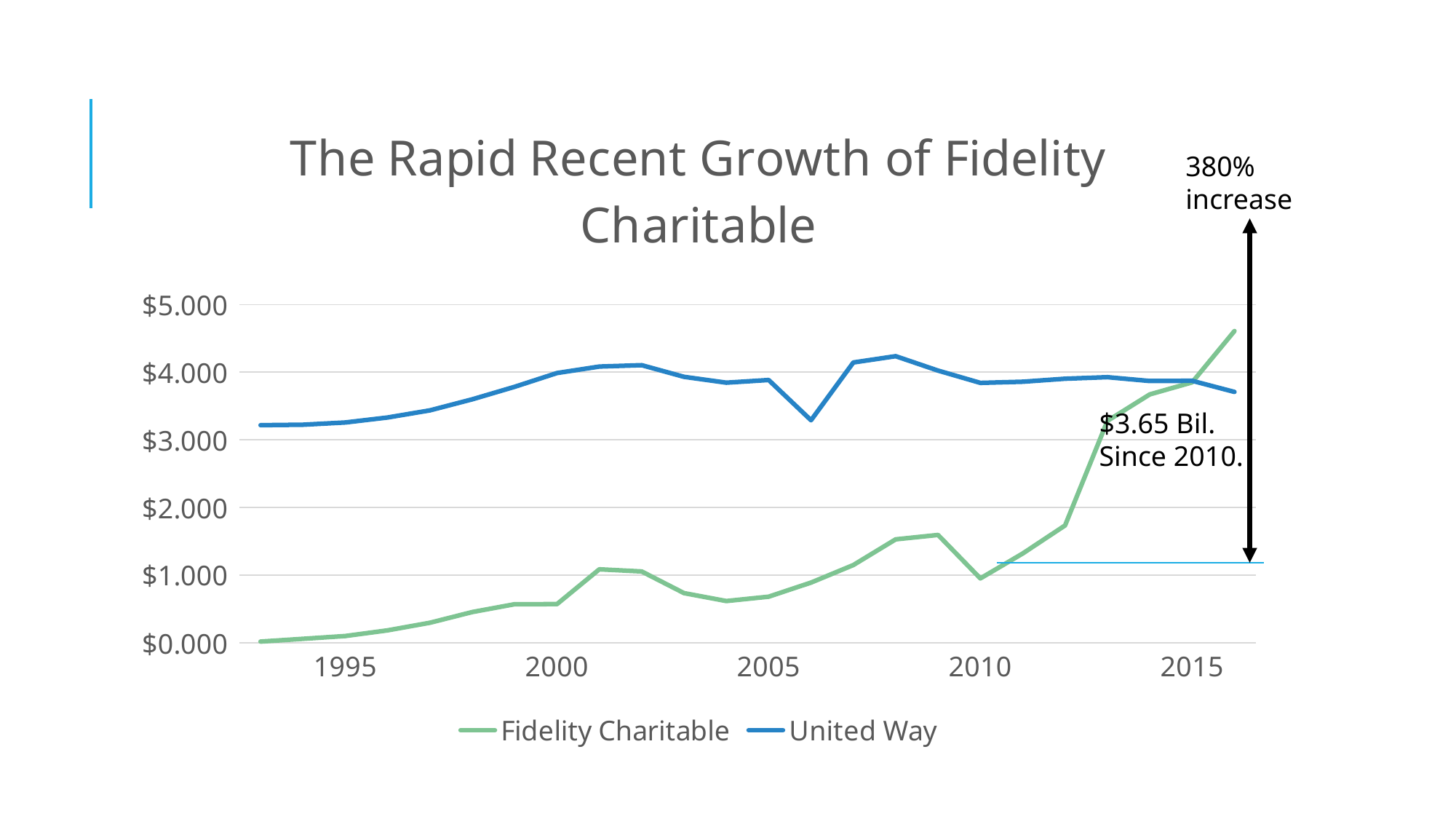
What kind of chart is shown on the slide? Line chart Does the United Way line rise or fall between 1995 and 2000? Rise How many year labels are shown on the x axis? 5 What are the two series named in the legend? Fidelity Charitable and United Way In 2005, which series has the higher value, Fidelity Charitable or United Way? United Way How many series does the legend list? 2 What is the title of the chart? The Rapid Recent Growth of Fidelity Charitable Is the value for United Way in 1995 greater or less than $3.000? greater Is the value for Fidelity Charitable in 2015 greater or less than $3.000? greater In 2010, which series has the higher value, Fidelity Charitable or United Way? United Way Does the Fidelity Charitable line rise or fall between 2010 and 2015? Rise Is the value for Fidelity Charitable in 2005 greater or less than $1.000? less